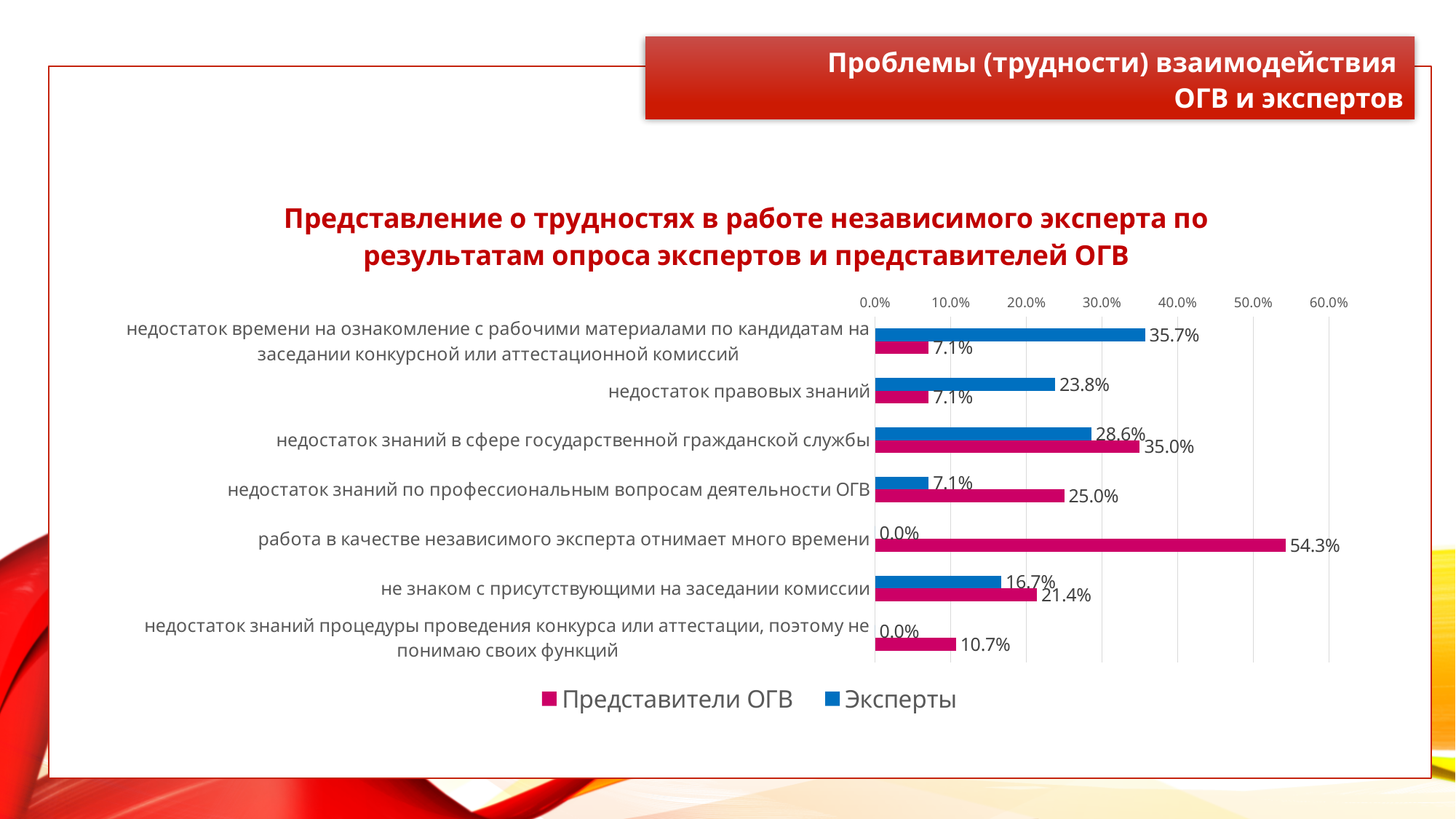
Which colour represents the Эксперты series in the chart? Blue How many series does the legend list? 2 What is the difference between Представители ОГВ and Эксперты for 'недостаток знаний по профессиональным вопросам деятельности ОГВ'? 17.9% What type of chart is shown on the slide? Bar chart Which category has the highest value for Представители ОГВ? работа в качестве независимого эксперта отнимает много времени What is the value for Представители ОГВ for 'работа в качестве независимого эксперта отнимает много времени'? 54.3% For 'недостаток знаний в сфере государственной гражданской службы', which series has the larger value: Представители ОГВ or Эксперты? Представители ОГВ What is the value for Эксперты for 'недостаток правовых знаний'? 23.8% How many categories are shown in the chart? 7 What is the value for Эксперты for 'недостаток знаний процедуры проведения конкурса или аттестации, поэтому не понимаю своих функций'? 0.0% Which category has the highest value for Эксперты? недостаток времени на ознакомление с рабочими материалами по кандидатам на заседании конкурсной или аттестационной комиссий What is the value for Эксперты for 'недостаток времени на ознакомление с рабочими материалами по кандидатам на заседании конкурсной или аттестационной комиссий'? 35.7%